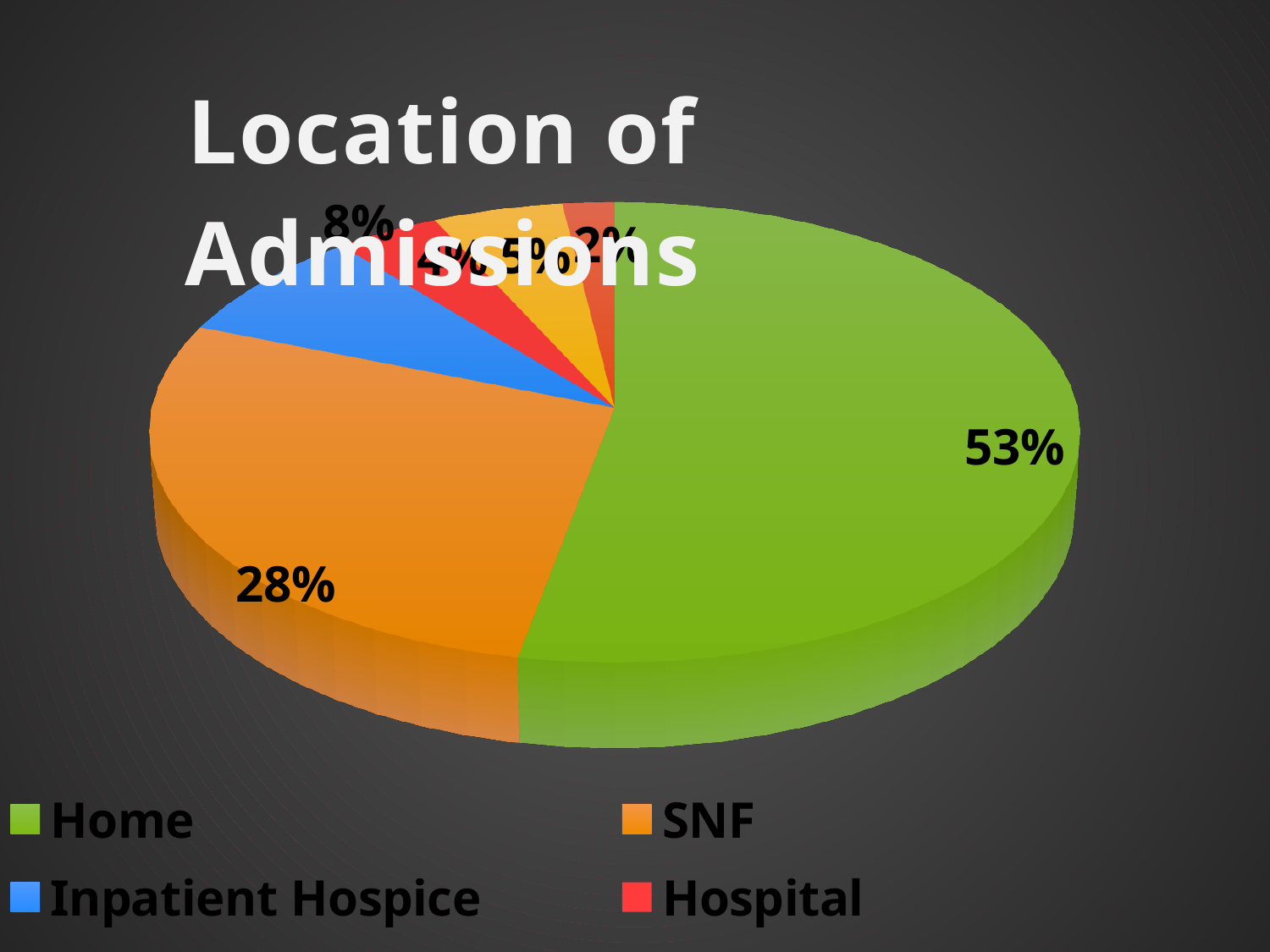
What is the title of the chart? Location of Admissions Which location accounts for the largest share of admissions? Home What is the difference in percentage points between the SNF and Inpatient Hospice shares? 20% Which is larger, the share for Home or the share for SNF? Home What percentage of admissions is shown for Inpatient Hospice? 8% What kind of chart is shown on the slide? pie chart Is the share for Home greater or less than 50%? greater What percentage of admissions is shown for SNF? 28% What percentage of admissions is shown for Home? 53% Which is larger, the share for SNF or the share for Inpatient Hospice? SNF What colour is the Home slice in the pie chart? green What is the difference in percentage points between the Home and SNF shares? 25%